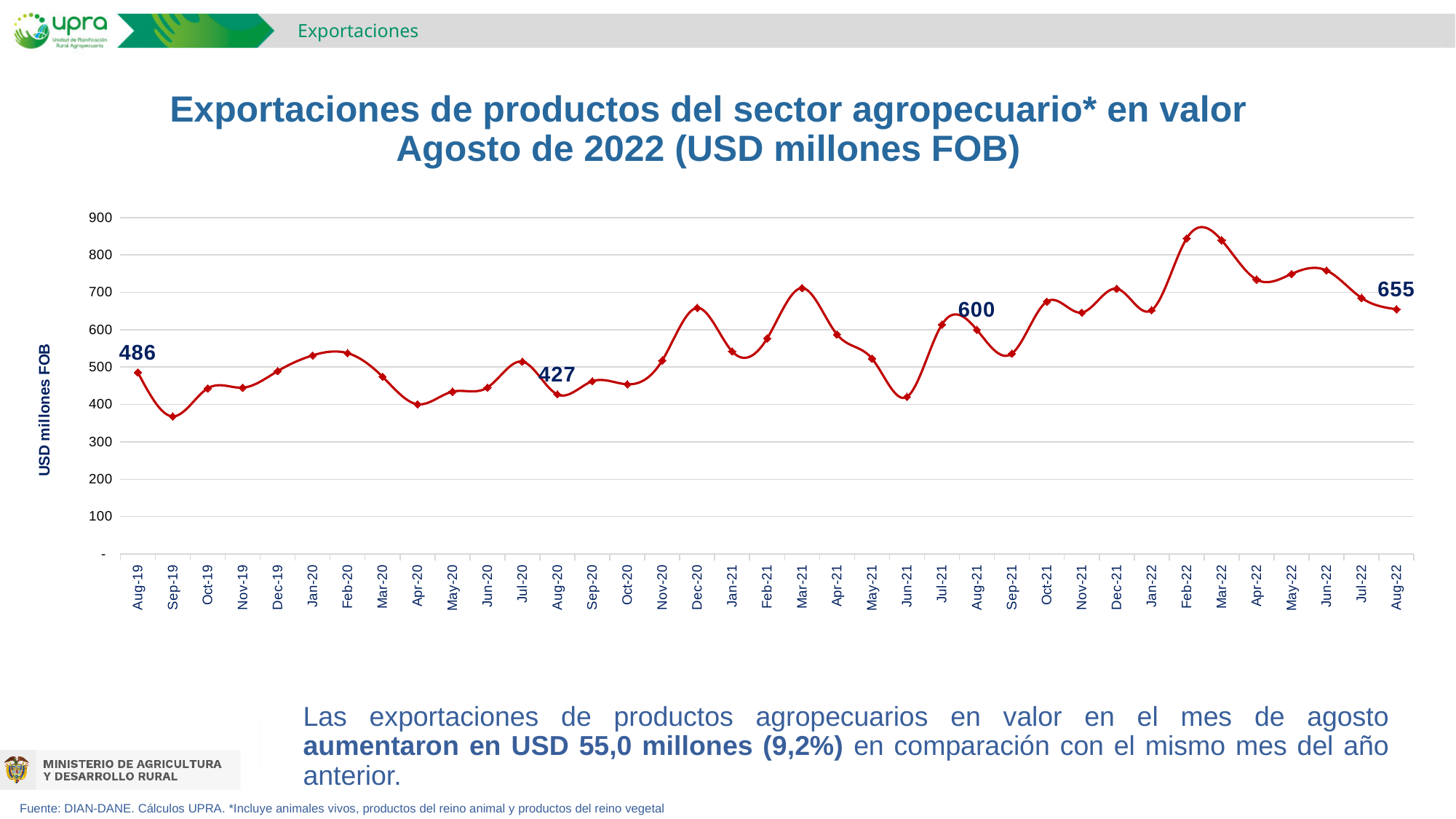
Which month has the lowest value on the chart? Sep-19 What is the label of the vertical axis? USD millones FOB What is the difference between the values for Aug-19 and Aug-20? 59 What type of chart is shown on the slide? Line chart What is the value for Aug-21? 600 What is the value for Aug-22? 655 What is the value for Aug-19? 486 What is the value for Aug-20? 427 Which month has the highest value on the chart? Feb-22 Is the value for Sep-19 greater or less than 400? less Is the value for Feb-22 greater or less than 800? greater What is the difference between the values for Aug-22 and Aug-21? 55